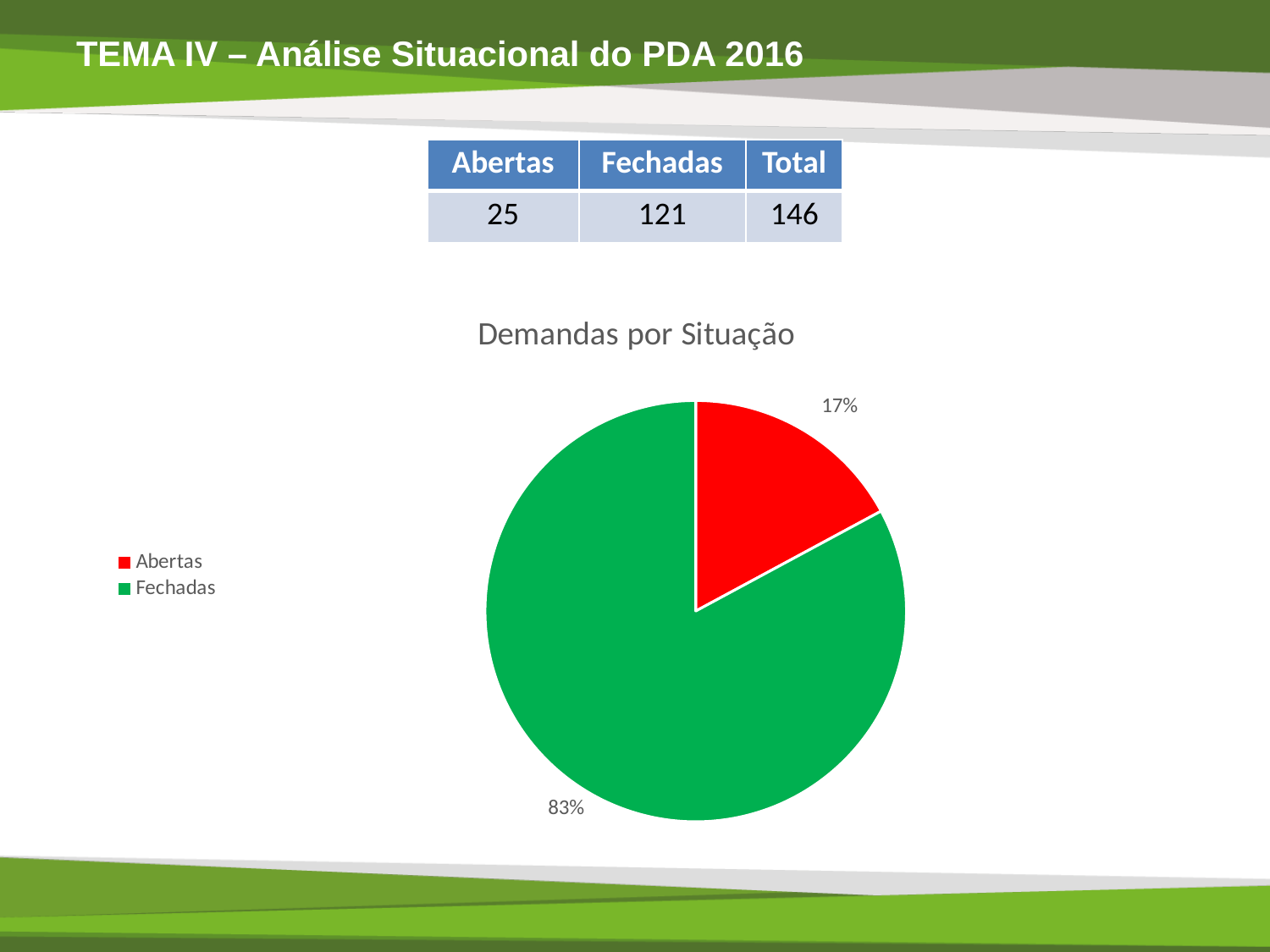
What percentage share does the Abertas slice have in the pie chart? 17% Which is larger in the pie chart, Abertas or Fechadas? Fechadas Which slice of the pie chart is the smallest? Abertas How many slices does the pie chart have? 2 How many entries does the legend list? 2 What percentage share does the Fechadas slice have in the pie chart? 83% What is the title of the chart? Demandas por Situação What type of chart is shown on the slide? pie chart Which slice of the pie chart is the largest? Fechadas What colour is the Abertas slice in the pie chart? red What is the difference in percentage points between the Fechadas and Abertas slices? 66 percentage points